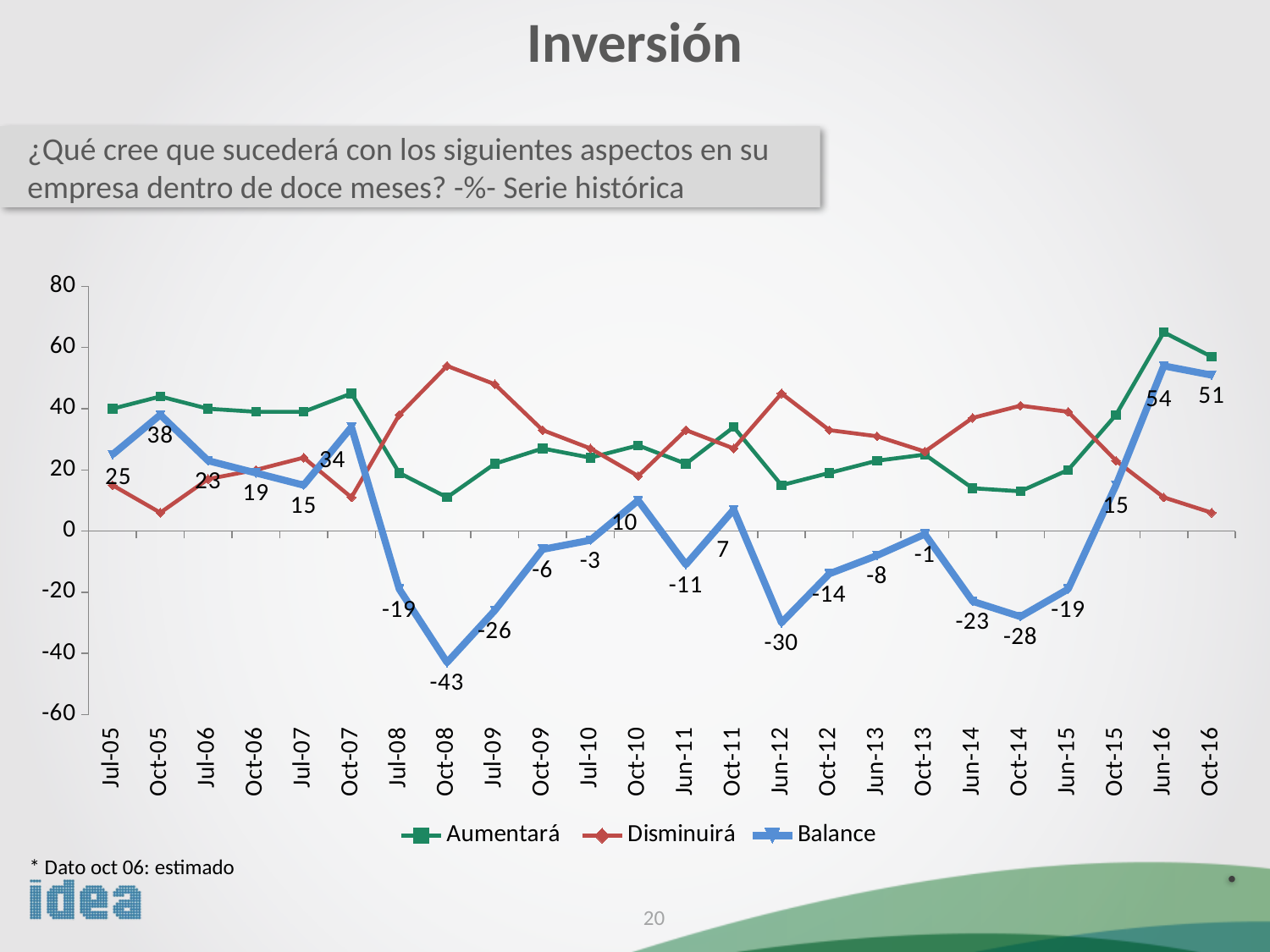
What is the difference between the Balance values for Jun-16 and Oct-16? 3 At which date is the Balance series highest? Jun-16 What is the Balance value for Jun-16? 54 What kind of chart is shown on the slide? line chart Is the Disminuirá value for Oct-08 greater or less than 40? greater How many series does the legend list? 3 At which date is the Balance series lowest? Oct-08 How many dates are shown on the x axis? 24 What is the Balance value for Oct-08? -43 What is the Balance value for Oct-05? 38 Which is larger, the Balance value for Oct-14 or for Jun-15? Jun-15 Is the Aumentará value for Jun-16 greater or less than 60? greater